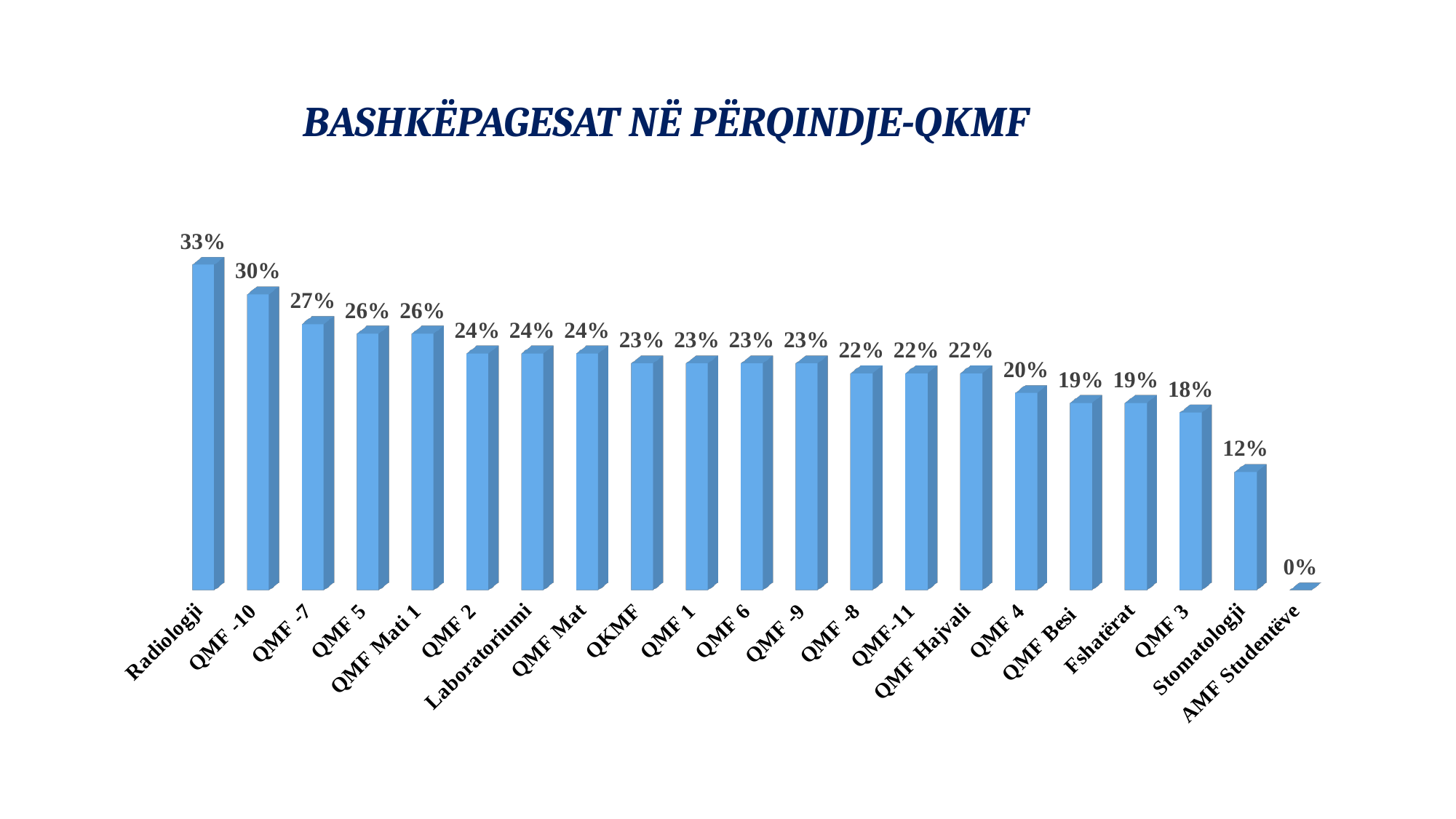
What is the value for Radiologji? 33% What is the value for QMF Hajvali? 22% Which category has the lowest value? AMF Studentëve What is the difference between the values for Radiologji and QMF -10? 3% What is the difference between the values for QMF 3 and Stomatologji? 6% What is the value for Laboratoriumi? 24% Which category has the highest value? Radiologji What kind of chart is this? Bar chart How many categories are shown in the chart? 21 What is the title of the chart? BASHKËPAGESAT NË PËRQINDJE-QKMF Which is larger, the value for QMF 5 or the value for QMF 4? QMF 5 What is the value for Stomatologji? 12%